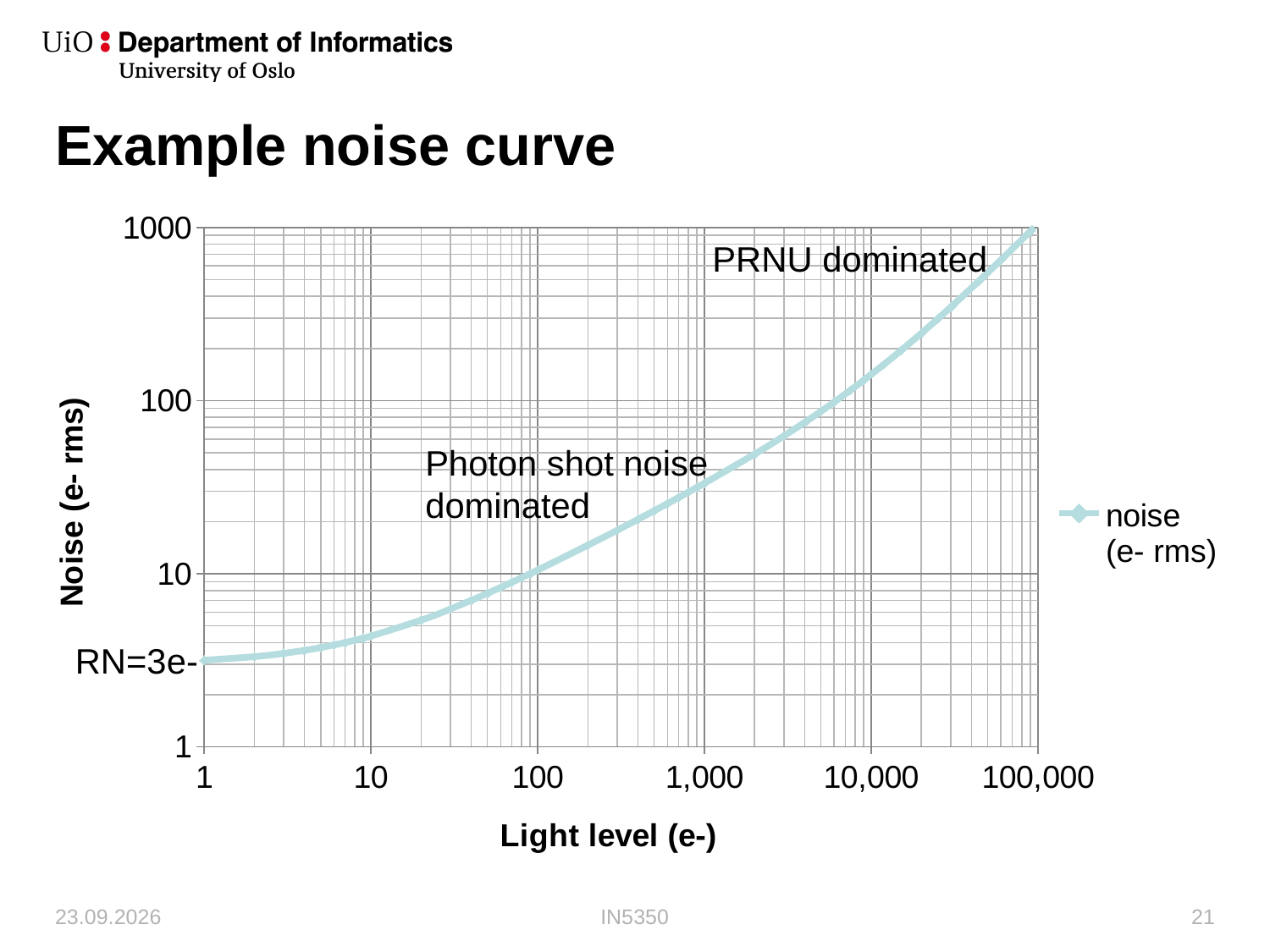
Is the noise value at a light level of 1 e- greater or less than 10? less Does the noise value rise or fall as the light level increases along the x axis? rise Which light level shown on the x axis has the lowest noise value? 1 Is the noise value at a light level of 1,000 e- greater or less than 10? greater Is the noise value at a light level of 100,000 e- greater or less than 100? greater Which light level shown on the x axis has the highest noise value? 100,000 What is the name of the series shown in the legend? noise (e- rms) What is the title of the slide's chart? Example noise curve What kind of chart is shown on the slide? line chart How many series does the legend list? 1